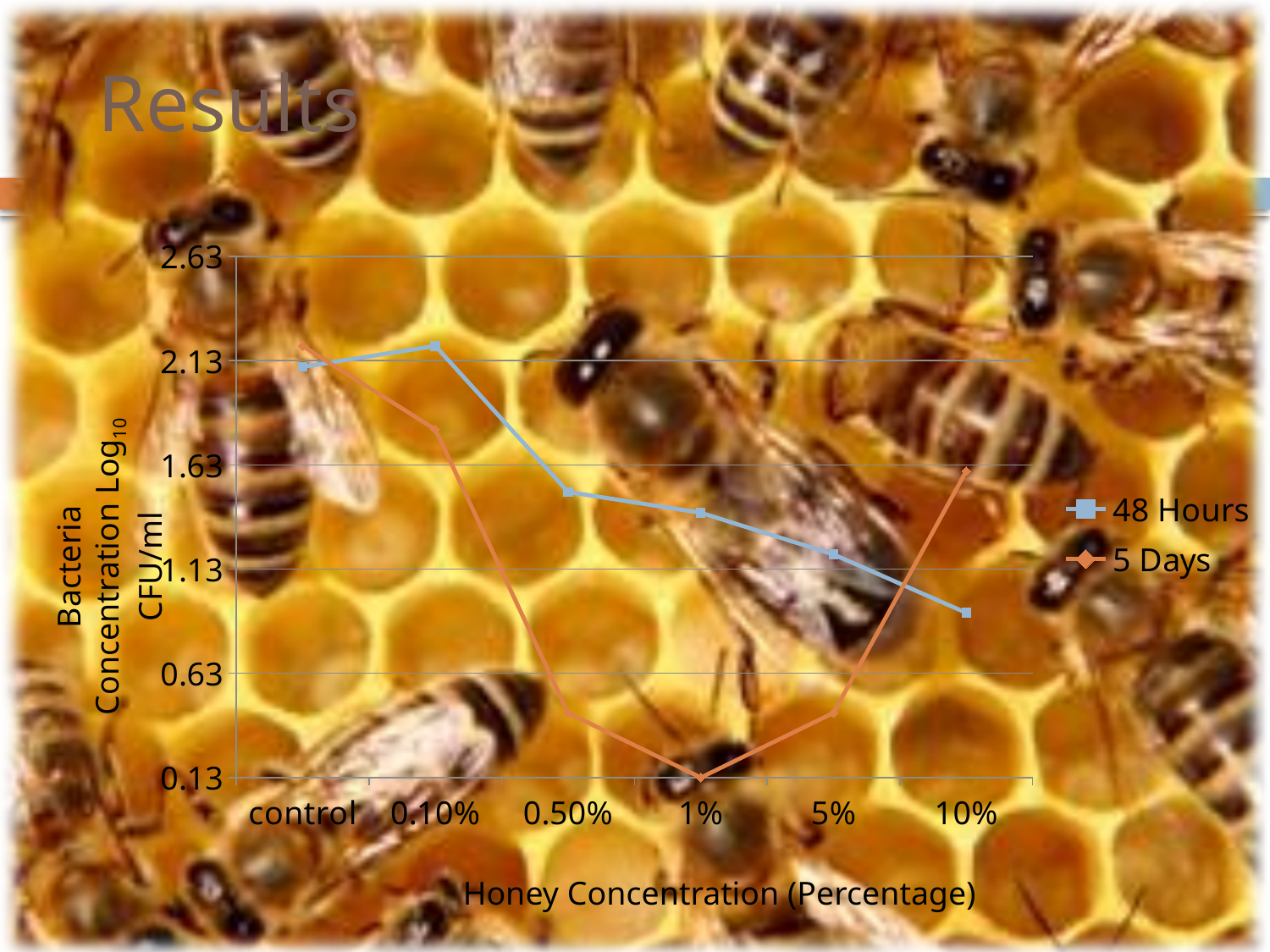
How many series does the legend list? 2 Which series are listed in the legend? 48 Hours and 5 Days What is the title of the x axis? Honey Concentration (Percentage) Is the 48 Hours value at 0.50% greater or less than 1.63? less At which honey concentration is the 48 Hours series lowest? 10% What kind of chart is shown on the slide? line chart At 5% honey concentration, which series has the higher value, 48 Hours or 5 Days? 48 Hours Is the 48 Hours value at 10% greater or less than 1.13? less Is the 5 Days value at 10% greater or less than 1.13? greater How many honey concentration categories are plotted on the x axis? 6 At which honey concentration is the 5 Days series lowest? 1%